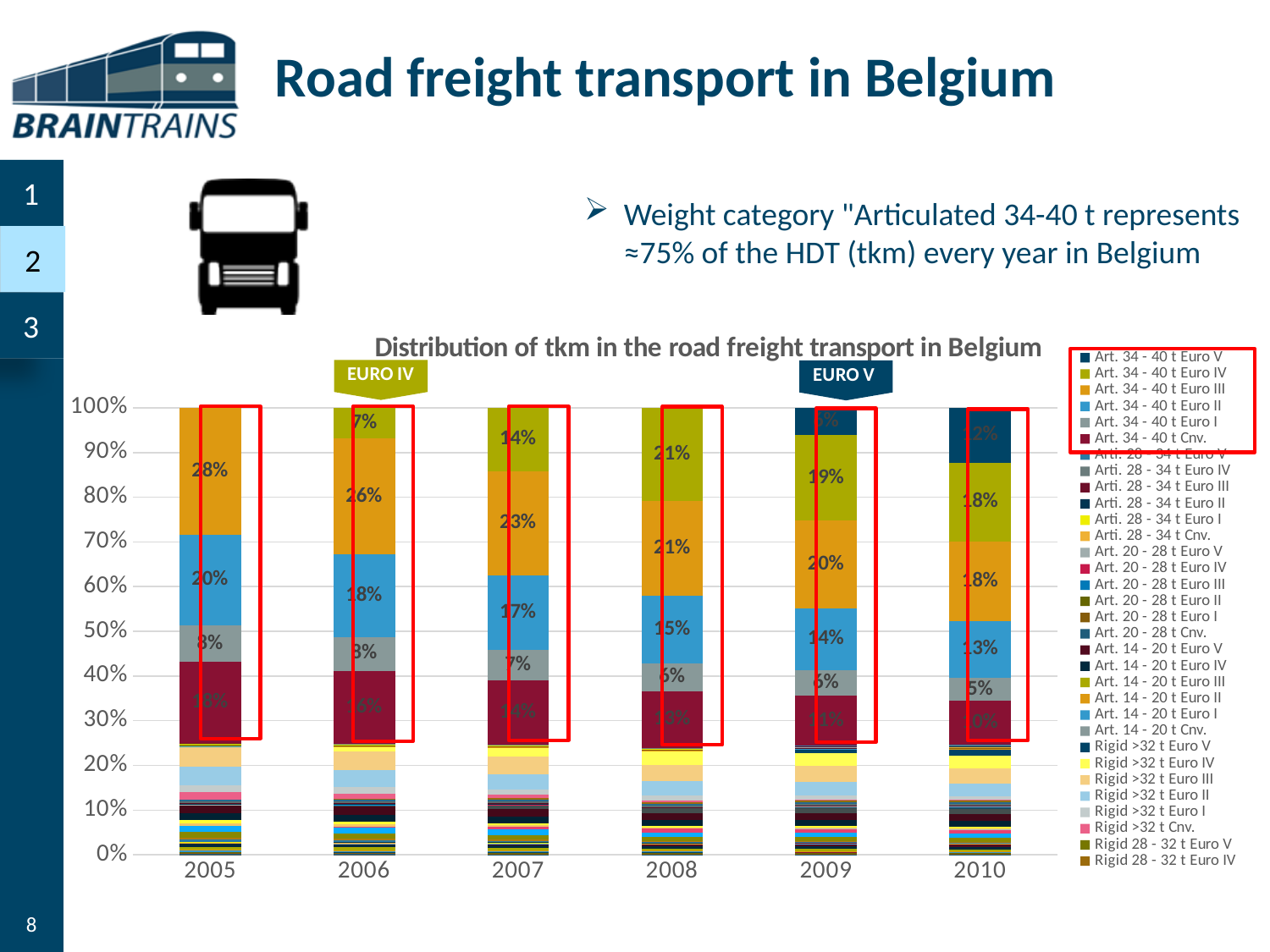
What share does the Art. 34 - 40 t Euro III segment have in 2006? 26% What kind of chart is shown on the slide? Stacked bar chart Which year has the largest share for the Art. 34 - 40 t Euro III segment? 2005 Which is larger: the Art. 34 - 40 t Euro II share in 2005 or in 2010? 2005 What share does the Art. 34 - 40 t Euro IV segment have in 2009? 19% By how many percentage points does the Art. 34 - 40 t Euro III share in 2005 exceed that in 2010? 10 percentage points What share does the Art. 34 - 40 t Euro IV segment have in 2007? 14% How many years are shown on the x axis of the chart? 6 What is the title of the chart? Distribution of tkm in the road freight transport in Belgium Does the share of the Art. 34 - 40 t Euro III segment rise or fall from 2005 to 2010? Fall What share does the Art. 34 - 40 t Euro III segment have in 2005? 28% What share does the Art. 34 - 40 t Euro II segment have in 2008? 15%